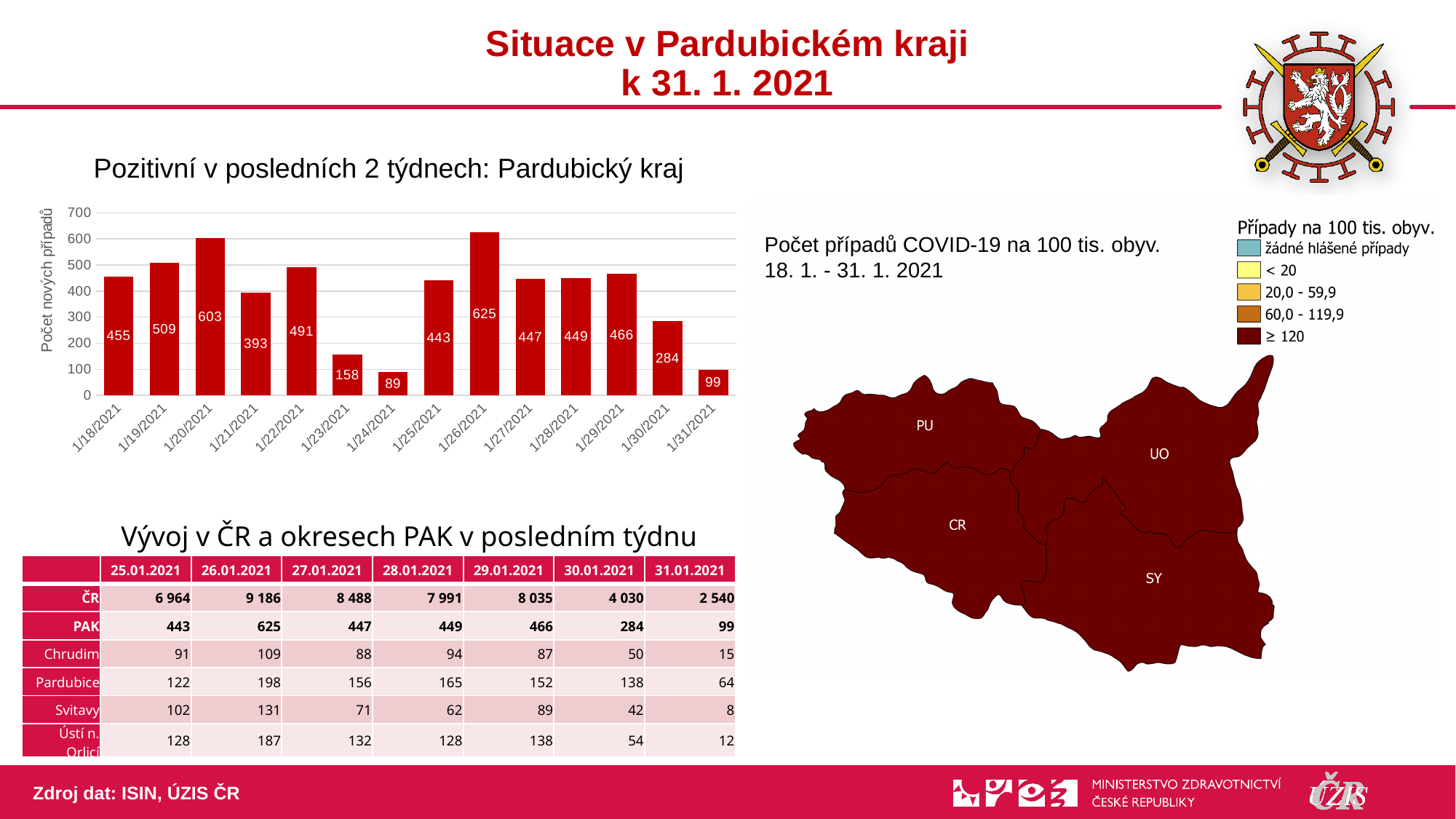
In the bar chart, what is the value for 1/30/2021? 284 In the bar chart, which date has the lowest value? 1/24/2021 How many dates are plotted in the bar chart? 14 What kind of chart is shown under the heading 'Pozitivní v posledních 2 týdnech: Pardubický kraj'? bar chart What is the label of the vertical axis of the bar chart? Počet nových případů In the bar chart, what is the value for 1/23/2021? 158 In the bar chart, is the value for 1/31/2021 greater or less than 200? less In the bar chart, which is larger: the value for 1/19/2021 or the value for 1/22/2021? 1/19/2021 In the bar chart, which date has the highest value? 1/26/2021 In the bar chart, what is the value for 1/20/2021? 603 In the bar chart, what is the difference between the values for 1/26/2021 and 1/20/2021? 22